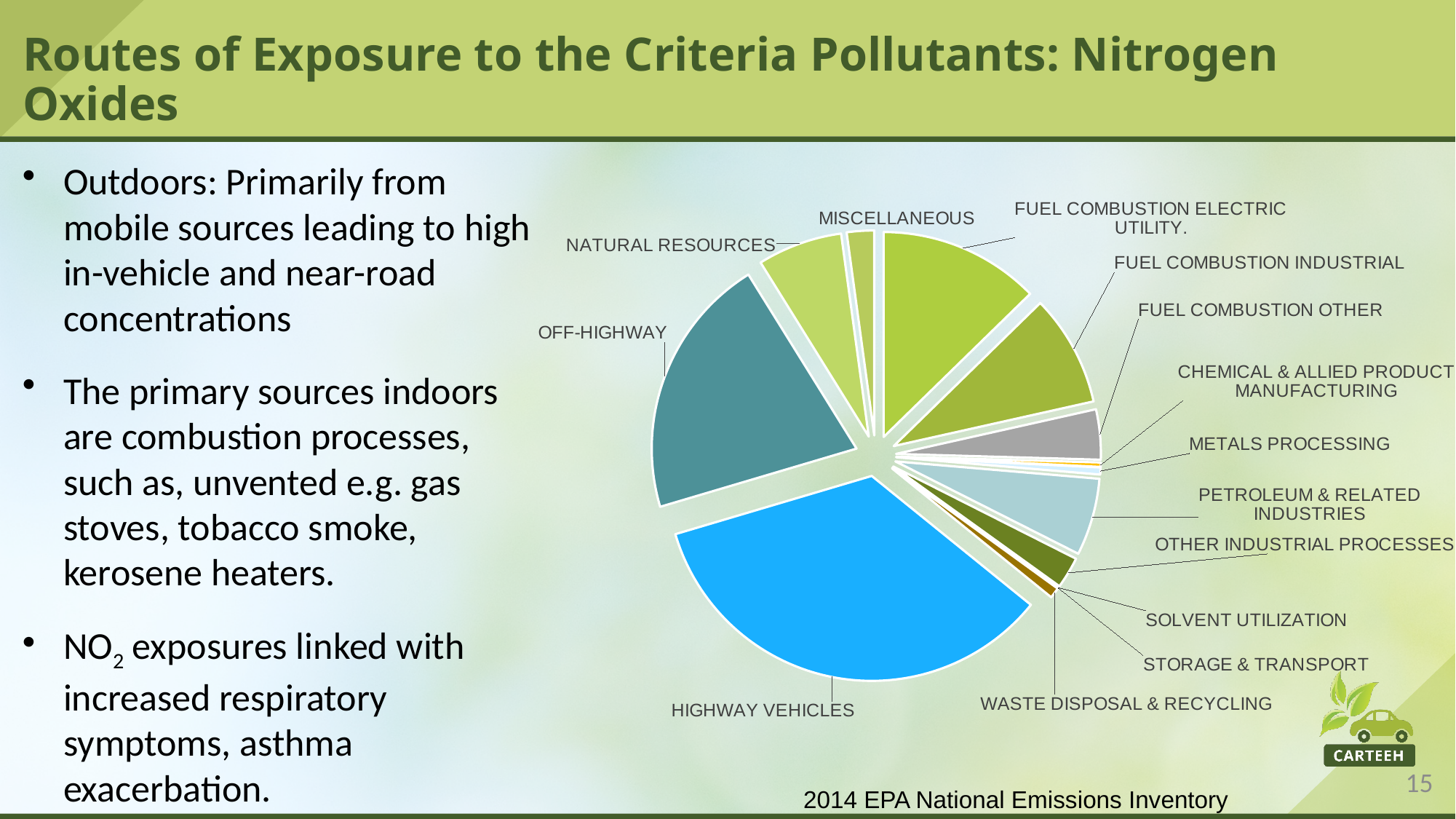
Is the Highway Vehicles slice greater or less than half of the pie? less Which slice is larger, Fuel Combustion Electric Utility or Fuel Combustion Industrial? Fuel Combustion Electric Utility Which slice is larger, Other Industrial Processes or Waste Disposal & Recycling? Other Industrial Processes Which slice is larger, Fuel Combustion Other or Metals Processing? Fuel Combustion Other What colour is the Highway Vehicles slice? blue What data source is cited below the pie chart? 2014 EPA National Emissions Inventory How many categories are shown in the pie chart? 14 Which category has the largest slice of the pie chart? Highway Vehicles What kind of chart is shown on the slide? pie chart